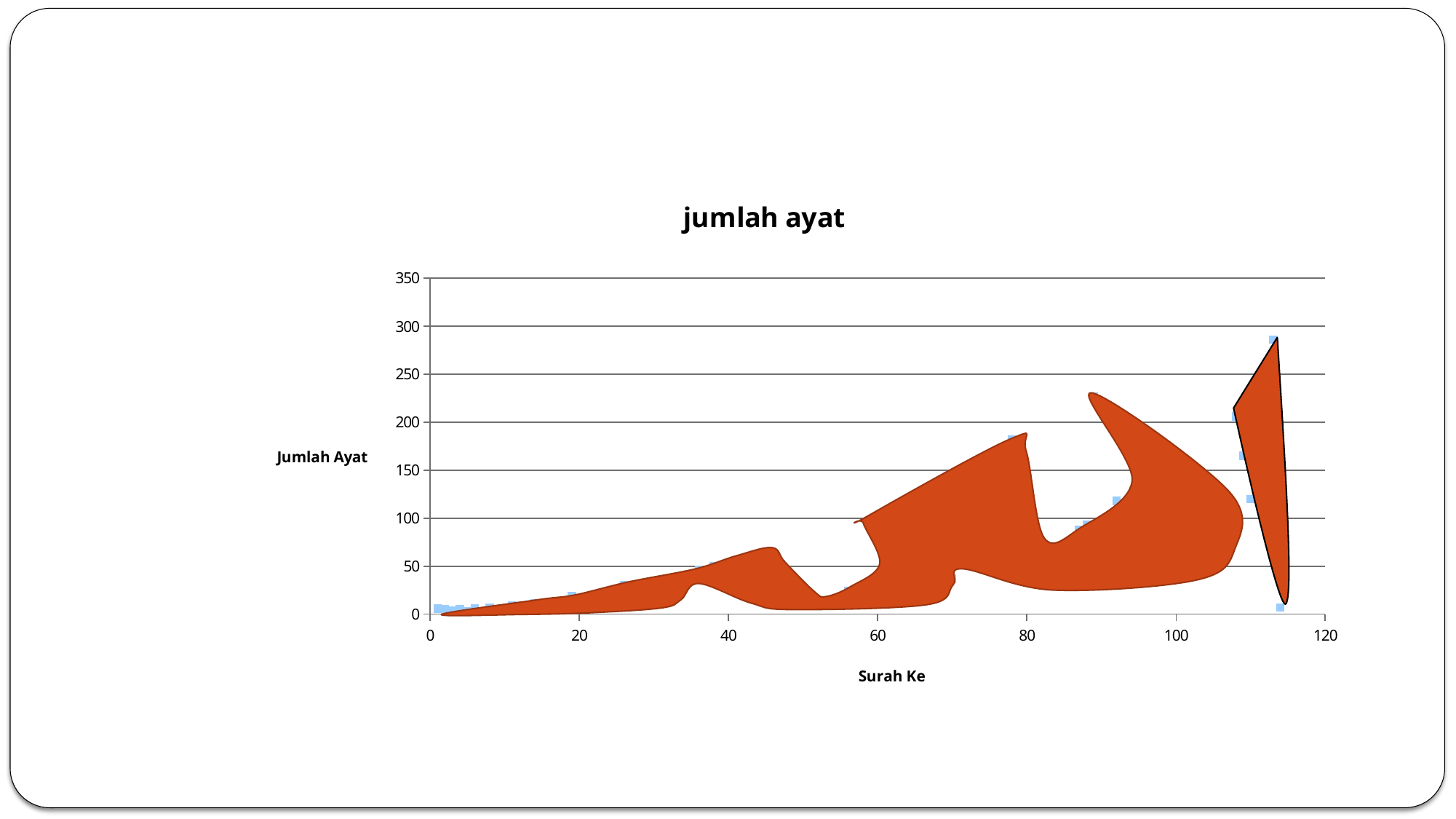
What is the maximum value shown on the vertical axis? 350 What is the title of the chart? jumlah ayat Is the value of the lowest point plotted near x = 114 greater or less than 50? less Is the value of the point plotted near x = 108 greater or less than 150? greater What kind of chart is shown on the slide? scatter chart Do the plotted values generally rise or fall as the x axis increases? rise What is the label of the horizontal axis? Surah Ke